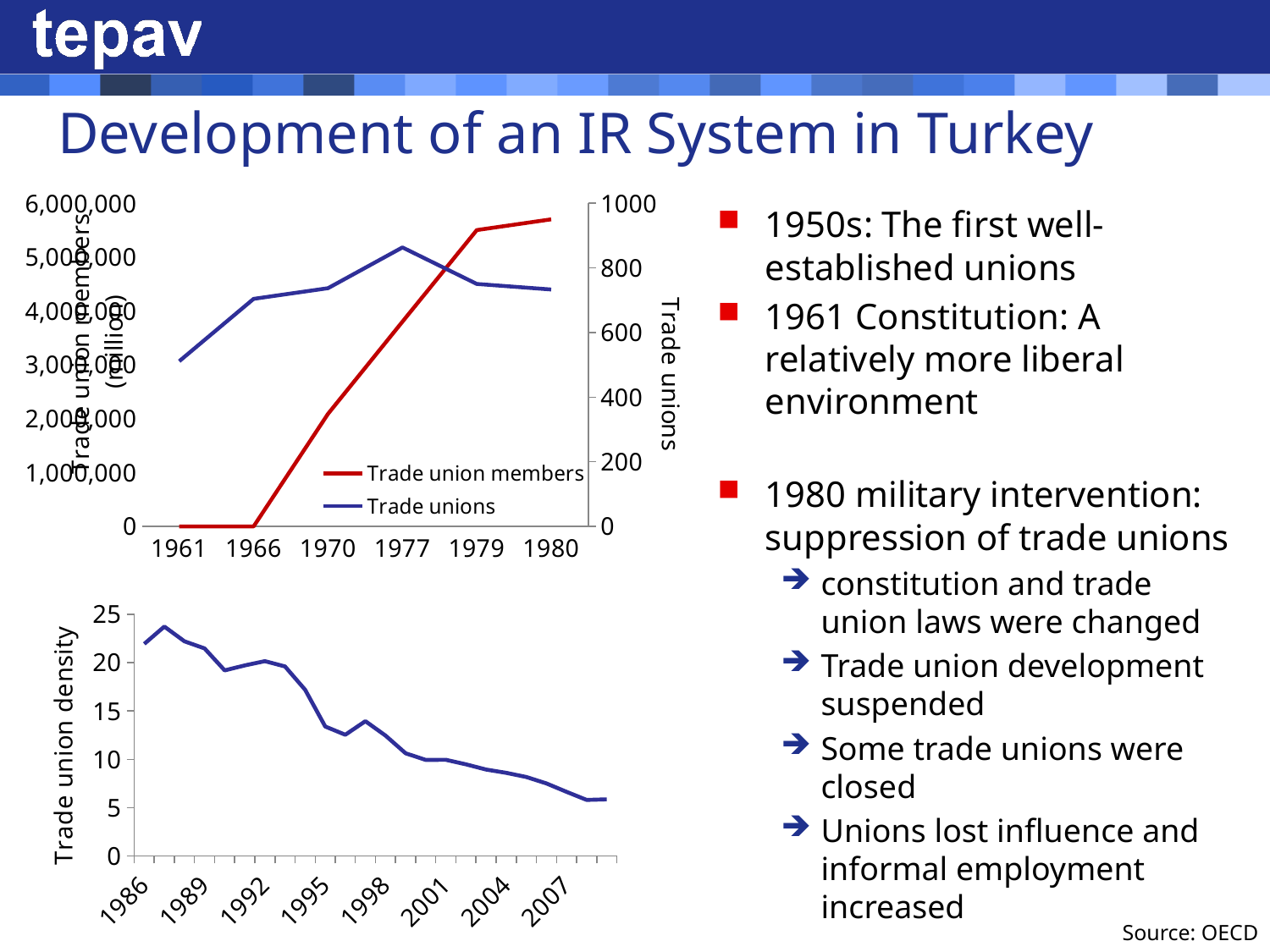
In the top chart, is the value for Trade unions in 1961 greater or less than 600? less In the top chart, is the value for Trade union members in 1980 greater or less than 5,000,000? greater In the bottom chart, does trade union density rise or fall overall from 1986 to the end of the series? fall How many years are shown on the x axis of the top chart? 6 In the top chart, what are the two series named in the legend? Trade union members and Trade unions In the top chart, do Trade union members rise or fall from 1966 to 1980? rise How many series does the legend of the top chart list? 2 In the bottom chart, is the trade union density in 1986 greater or less than 20? greater What kind of chart is the top chart on the slide? line chart In the top chart, in which year is the Trade unions series at its highest? 1977